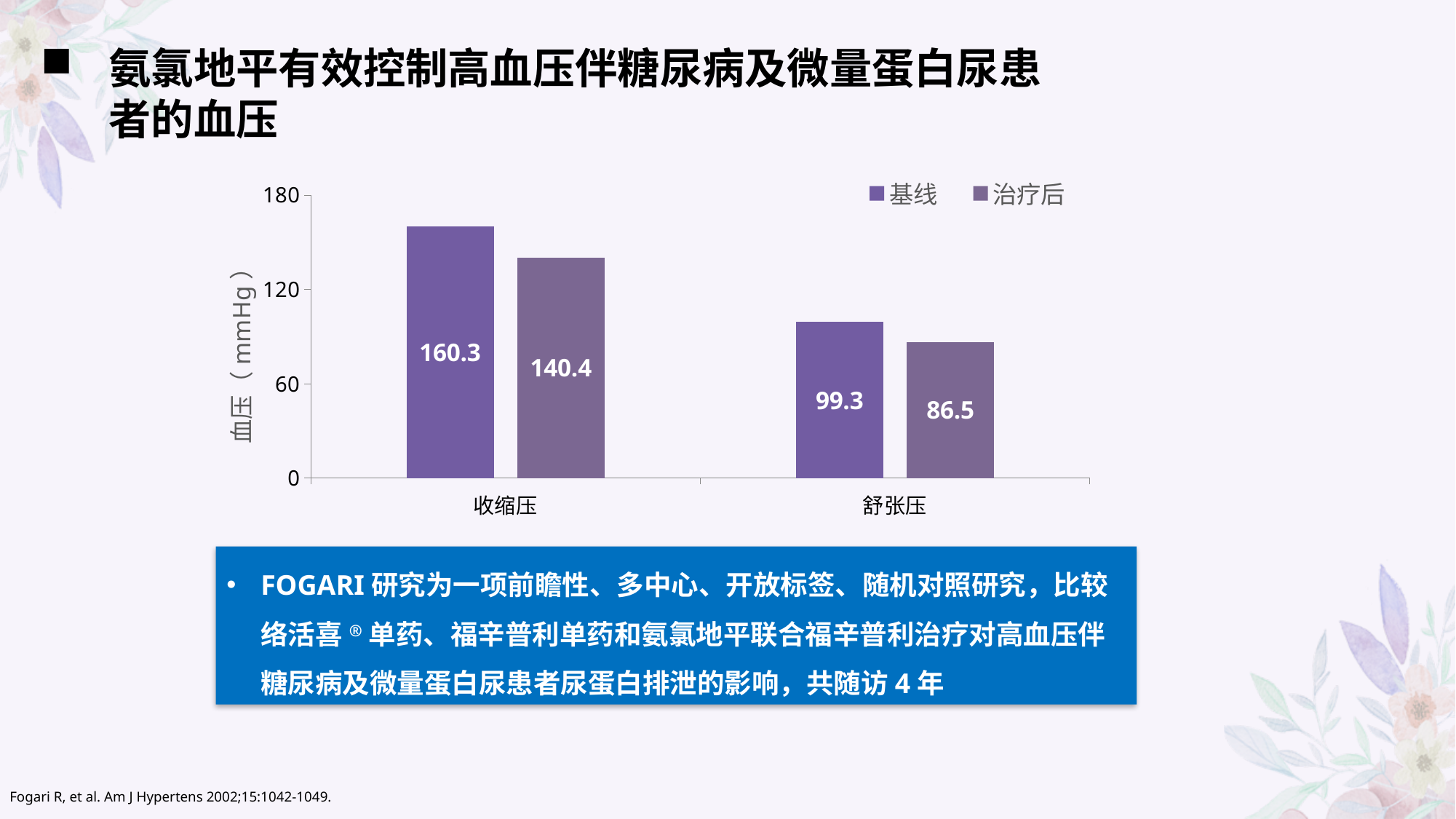
How many categories are shown on the x axis? 2 What is the 治疗后 value for 收缩压? 140.4 What is the difference between the 基线 and 治疗后 values for 收缩压? 19.9 Which is larger, the 基线 value for 舒张压 or the 治疗后 value for 舒张压? 基线 What is the 基线 value for 收缩压? 160.3 Which bar has the highest value in the chart? 基线 收缩压 What is the difference between the 基线 and 治疗后 values for 舒张压? 12.8 What is the 治疗后 value for 舒张压? 86.5 What is the 基线 value for 舒张压? 99.3 What kind of chart is shown on the slide? bar chart Which bar has the lowest value in the chart? 治疗后 舒张压 How many series does the legend list? 2